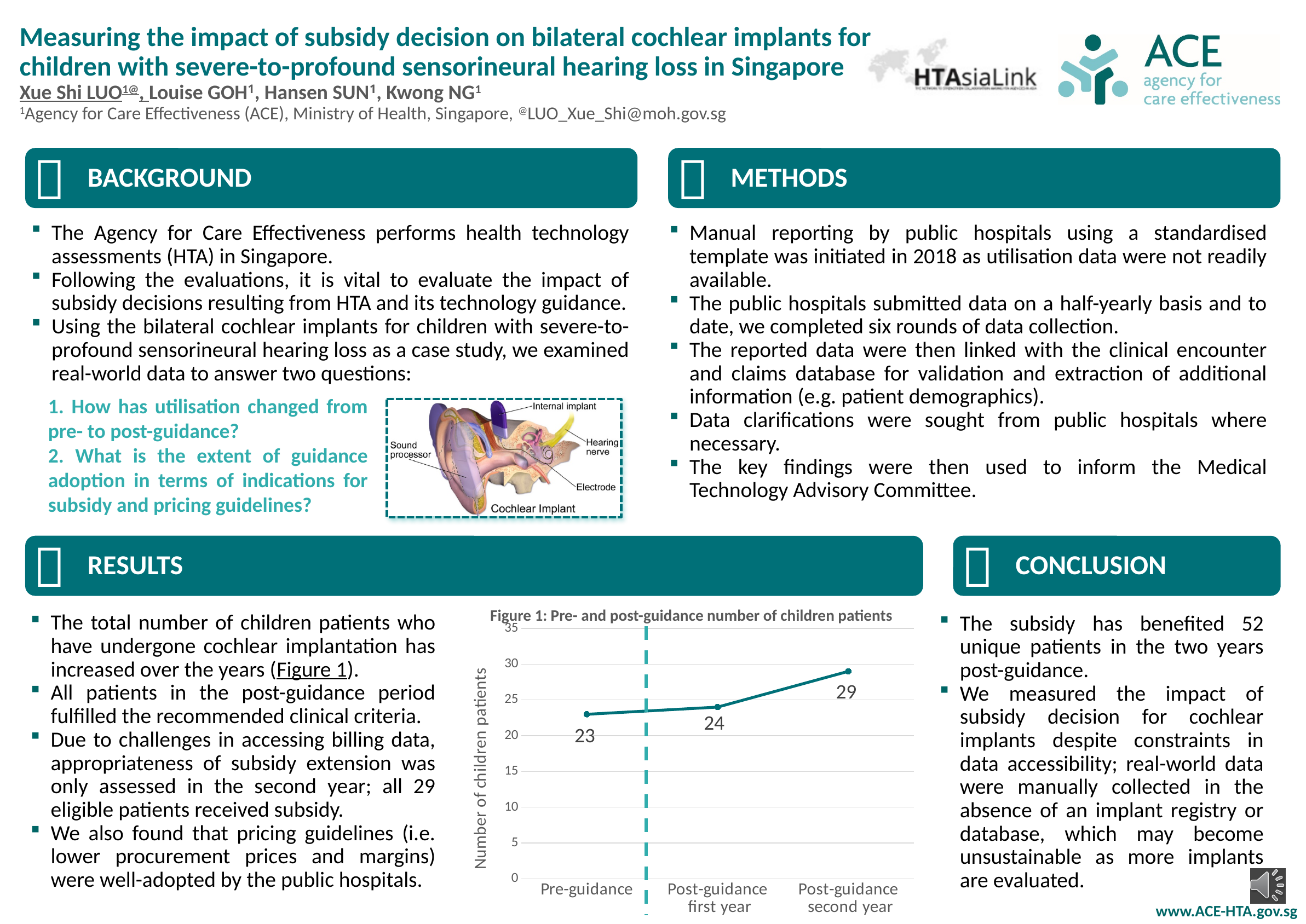
What is the difference in number of children patients between Post-guidance second year and Post-guidance first year in Figure 1? 5 What kind of chart is Figure 1? line chart What is the difference in number of children patients between Post-guidance second year and Pre-guidance in Figure 1? 6 What is the number of children patients for Post-guidance first year in Figure 1? 24 What is the number of children patients for Post-guidance second year in Figure 1? 29 Do the values in Figure 1 rise or fall from Pre-guidance to Post-guidance second year? rise Which period has the highest number of children patients in Figure 1? Post-guidance second year Which period has the lowest number of children patients in Figure 1? Pre-guidance What is the number of children patients for Pre-guidance in Figure 1? 23 Is the value for Post-guidance second year in Figure 1 greater or less than 25? greater Which is larger in Figure 1: the value for Pre-guidance or for Post-guidance second year? Post-guidance second year How many periods are plotted on the x axis of Figure 1? 3